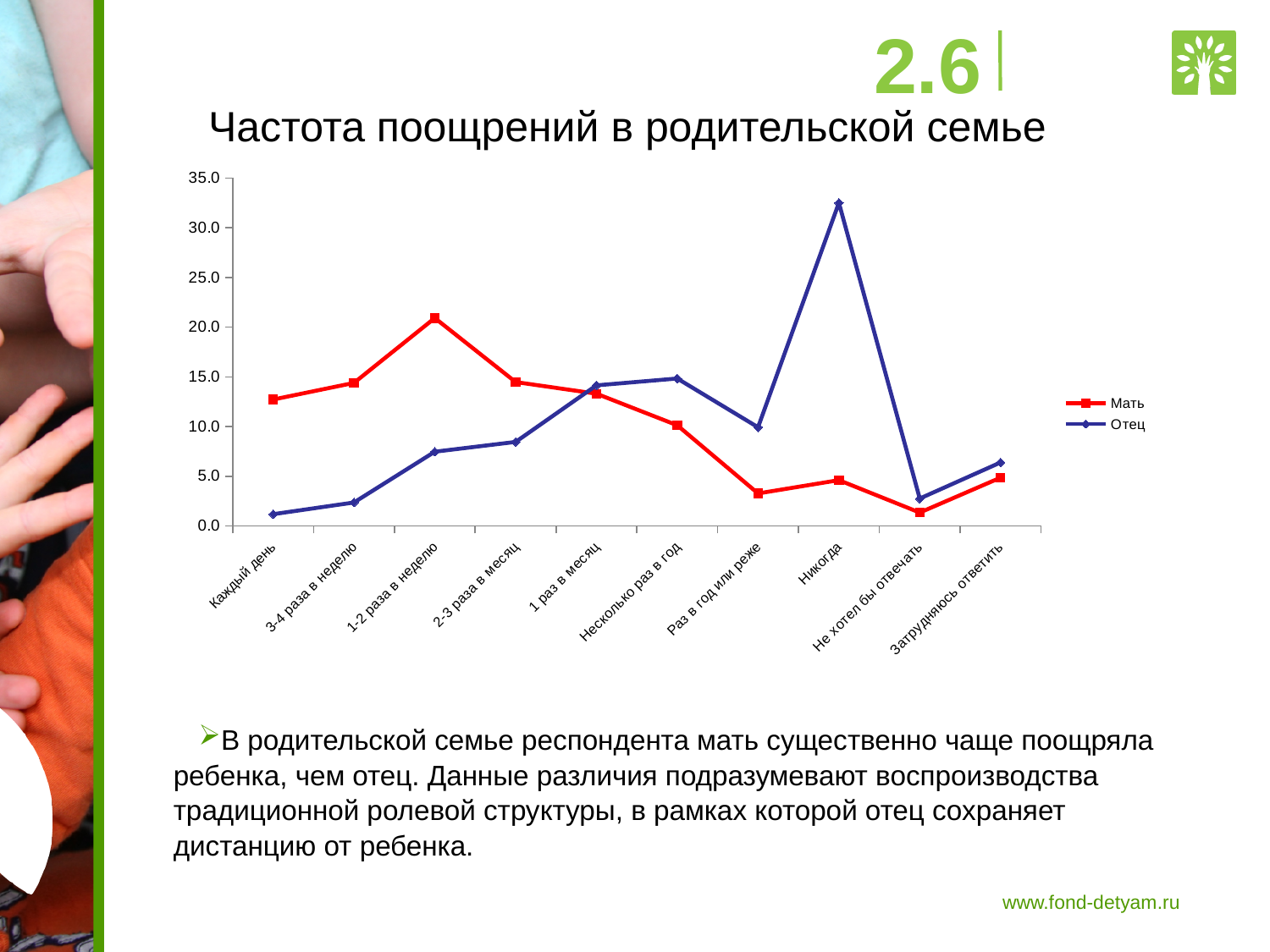
Does the Мать series rise or fall from 1-2 раза в неделю to Раз в год или реже? fall Which series has the larger value at Каждый день, Мать or Отец? Мать Is the value for Отец at Каждый день greater or less than 5.0? less Is the value for Мать at Каждый день greater or less than 10.0? greater For which category does the Отец series reach its highest value? Никогда What kind of chart is shown on the slide? line chart How many categories are shown on the x axis? 10 For which category does the Отец series have its lowest value? Каждый день How many series does the legend list? 2 For which category does the Мать series have its lowest value? Не хотел бы отвечать Is the value for Отец at Никогда greater or less than 30.0? greater For which category does the Мать series reach its highest value? 1-2 раза в неделю